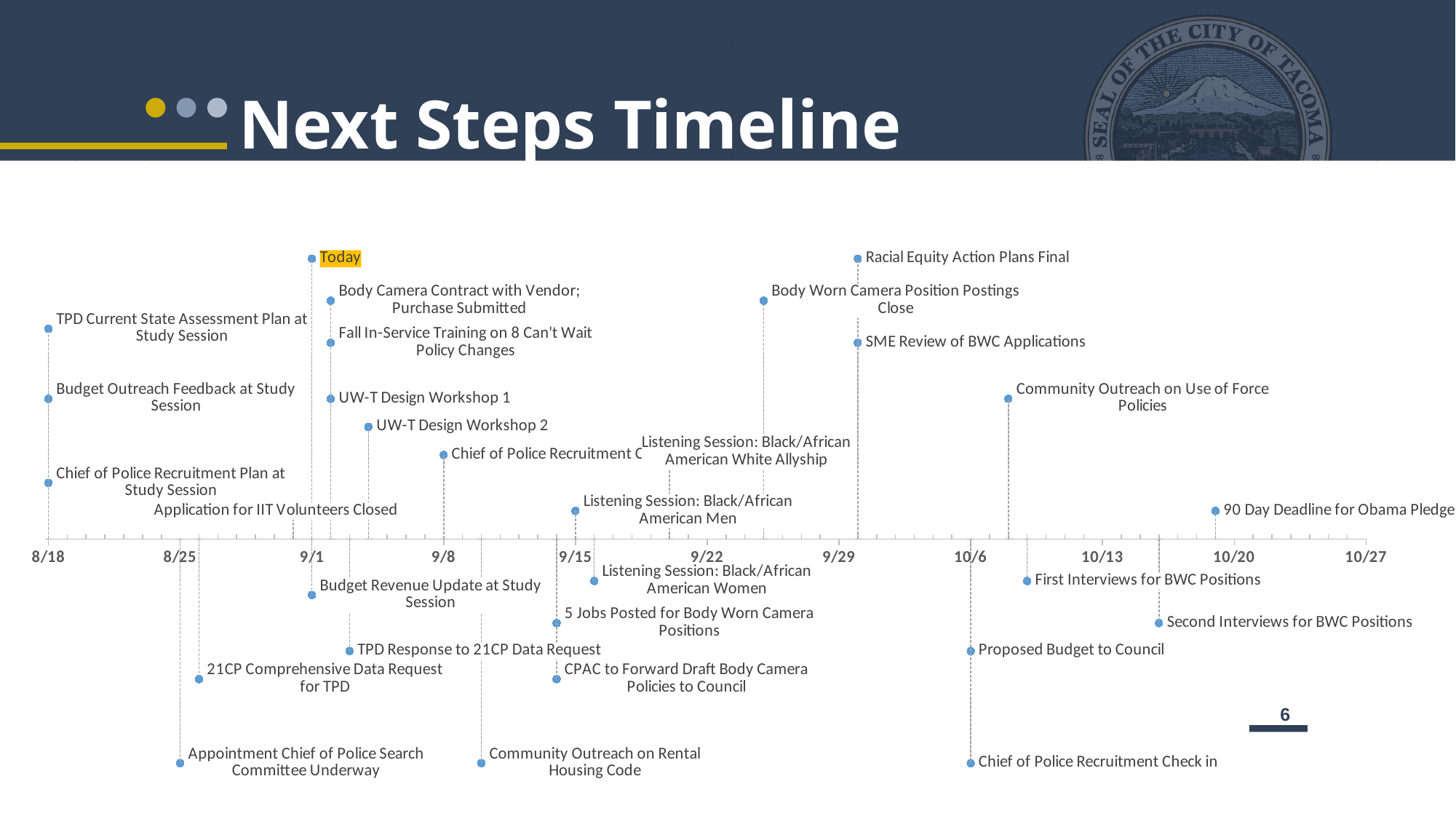
On what date is the 'Today' marker placed on the timeline? 9/1 Which event is placed latest on the timeline? 90 Day Deadline for Obama Pledge What kind of chart is shown on the slide? Timeline chart How many date labels are shown on the timeline axis? 11 Does 'Second Interviews for BWC Positions' come before or after 'First Interviews for BWC Positions' on the timeline? after What is the first date shown on the timeline axis? 8/18 Which label on the timeline is highlighted in yellow? Today What is the title of the chart on the slide? Next Steps Timeline On what date is 'Proposed Budget to Council' placed on the timeline? 10/6 On what date is 'Chief of Police Recruitment Check in' placed on the timeline? 10/6 On what date is 'Appointment Chief of Police Search Committee Underway' placed on the timeline? 8/25 Is 'Community Outreach on Use of Force Policies' placed before or after 10/6 on the timeline? after